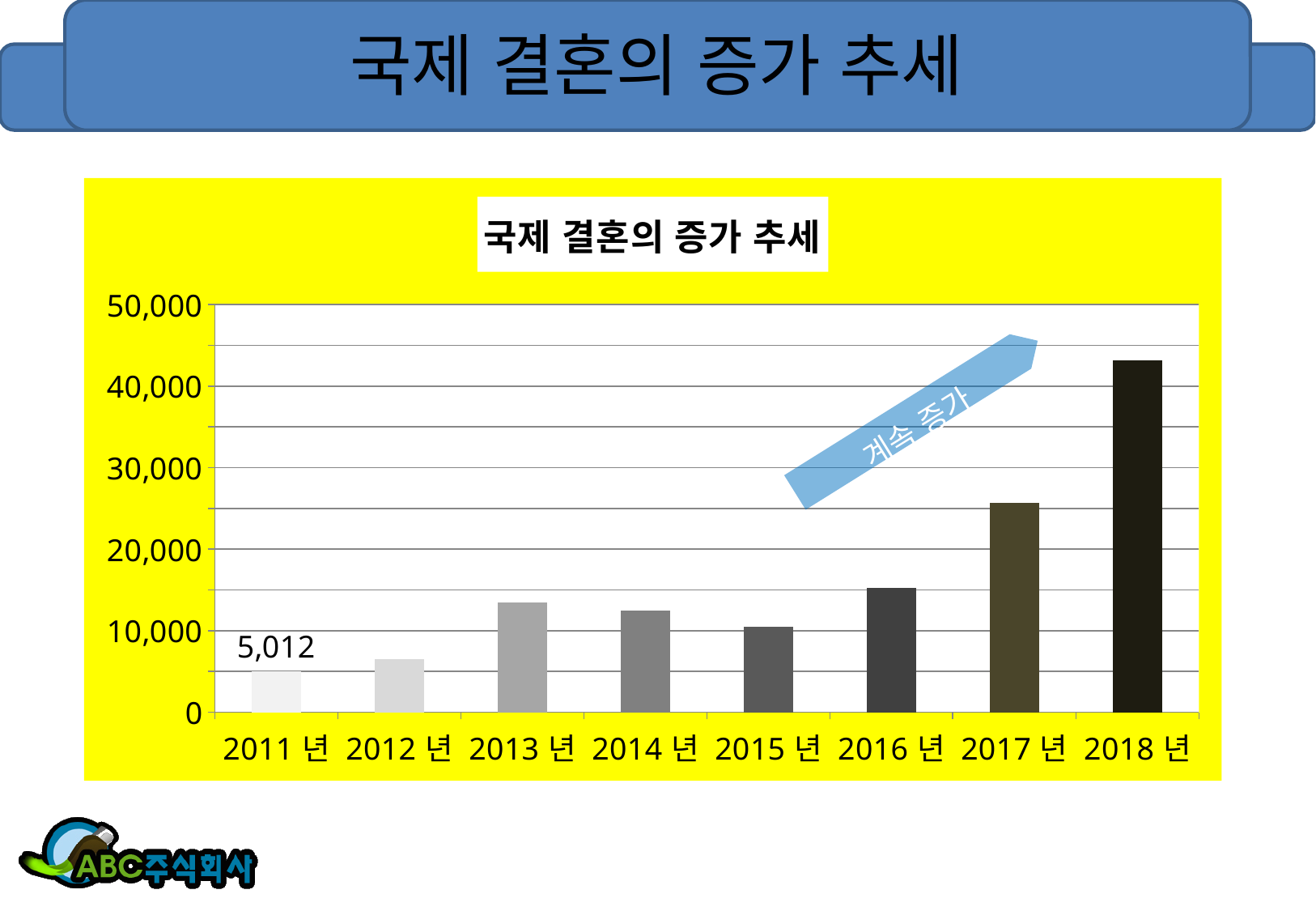
Is the value for 2017 년 greater or less than 20,000? greater Which is larger, the value for 2017 년 or 2016 년? 2017 년 Is the value for 2018 년 greater or less than 40,000? greater Is the value for 2012 년 greater or less than 10,000? less Which year has the highest value? 2018 년 What kind of chart is shown on the slide? bar chart Which year has the lowest value? 2011 년 What is the title of the chart? 국제 결혼의 증가 추세 How many years are shown on the x axis? 8 From 2015 년 to 2018 년, do the values rise or fall? rise What is the value for 2011 년? 5,012